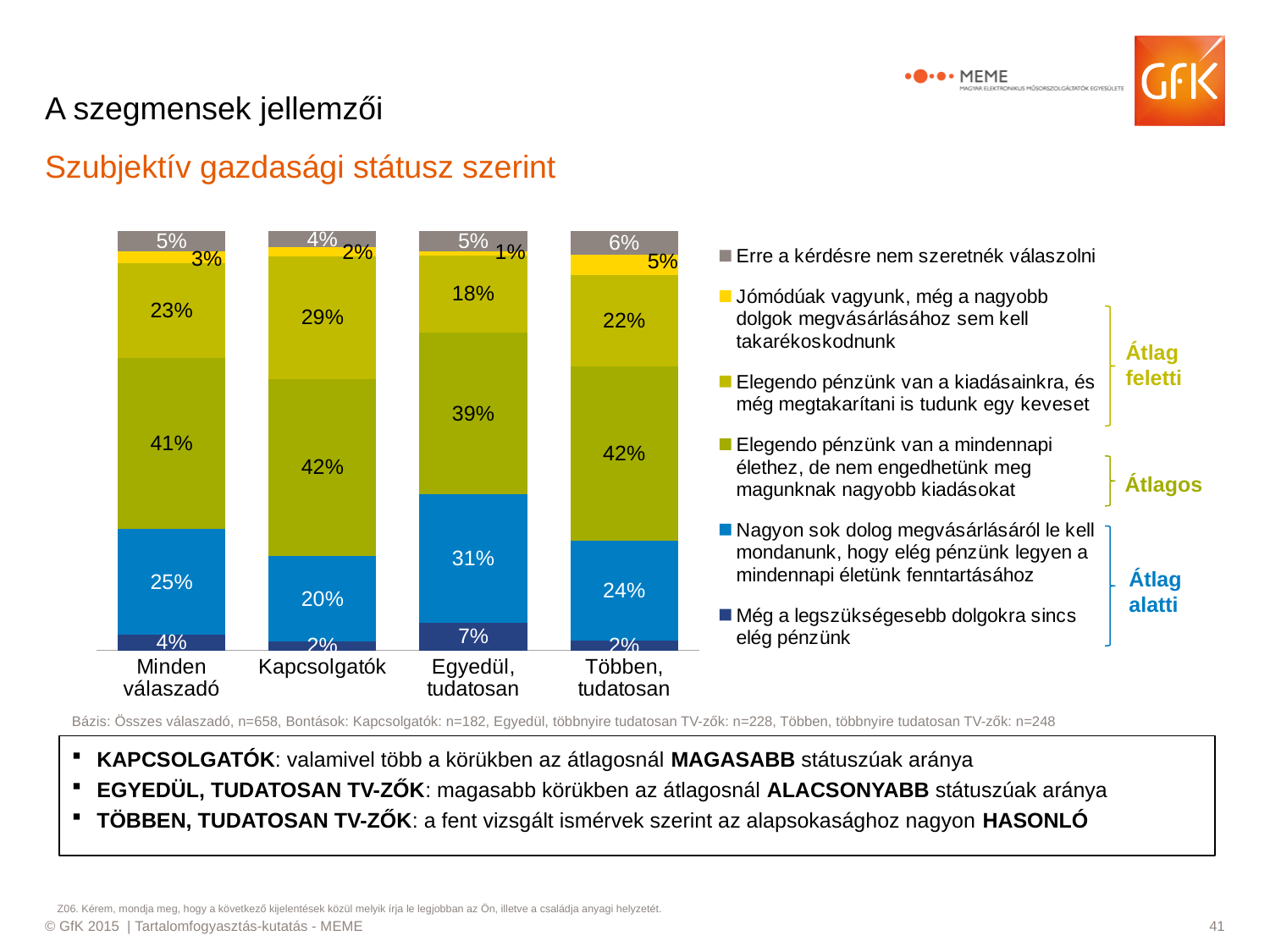
What is the value of the 'Erre a kérdésre nem szeretnék válaszolni' segment for 'Többen, tudatosan'? 6% Which is larger: the 'Elegendo pénzünk van a kiadásainkra...' (olive-green) value for 'Minden válaszadó' or for 'Egyedül, tudatosan'? Minden válaszadó What is the value of the 'Jómódúak vagyunk...' (yellow) segment for 'Többen, tudatosan'? 5% Which category has the highest value for the 'Elegendo pénzünk van a kiadásainkra, és még megtakarítani is tudunk egy keveset' segment? Kapcsolgatók How many entries does the chart legend list? 6 What is the value of the 'Még a legszükségesebb dolgokra sincs elég pénzünk' segment for 'Egyedül, tudatosan'? 7% What is the difference between the 'Nagyon sok dolog megvásárlásáról le kell mondanunk...' (blue) values for 'Egyedül, tudatosan' and 'Minden válaszadó'? 6% What is the value of the 'Nagyon sok dolog megvásárlásáról le kell mondanunk...' (blue) segment for 'Kapcsolgatók'? 20% How many categories (bars) are shown on the x axis of the chart? 4 What type of chart is shown on the slide? stacked bar chart Which category has the lowest value for the 'Jómódúak vagyunk...' (yellow) segment? Egyedül, tudatosan What is the value of the 'Elegendo pénzünk van a mindennapi élethez, de nem engedhetünk meg magunknak nagyobb kiadásokat' segment for 'Egyedül, tudatosan'? 39%